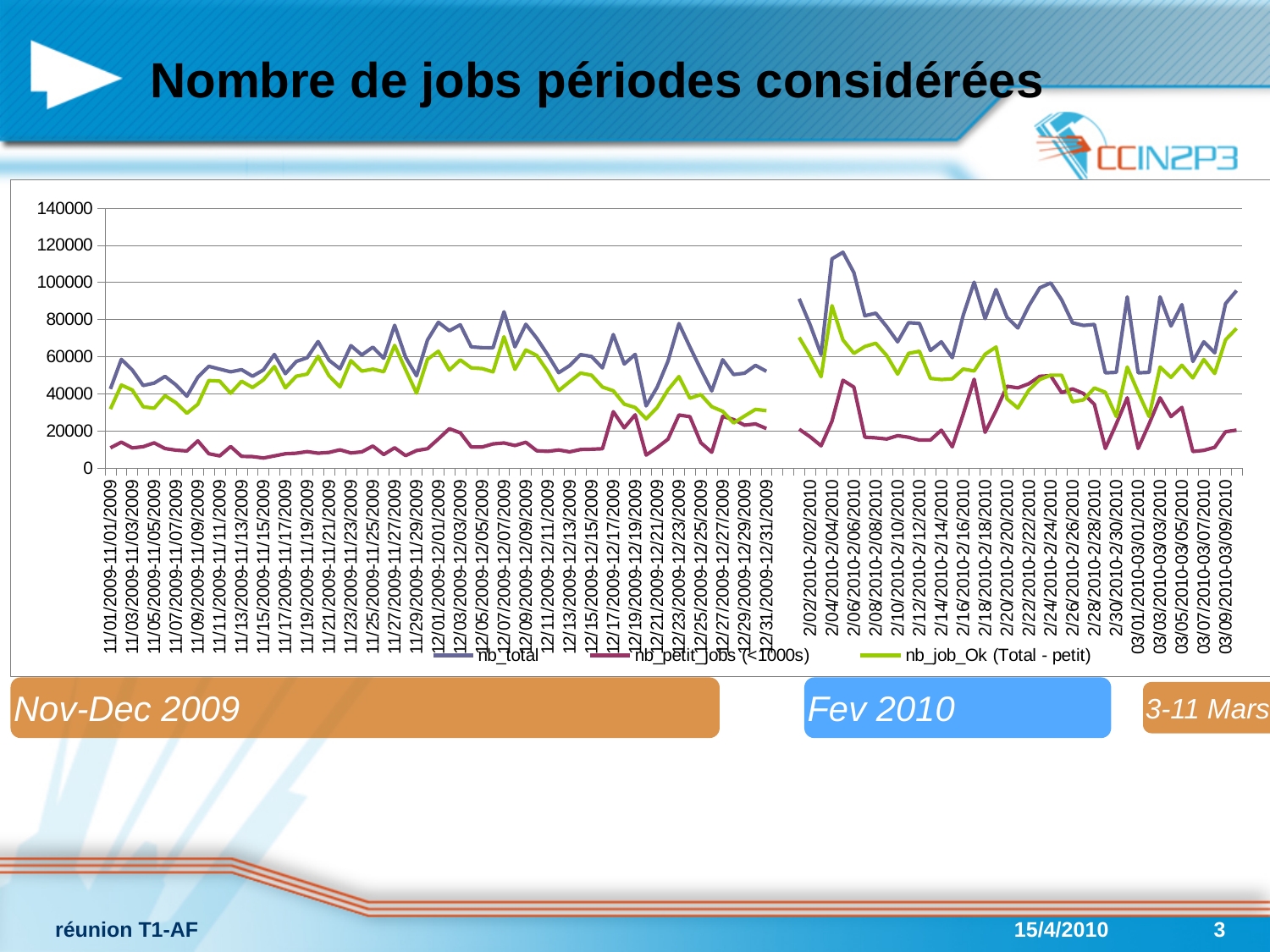
At 2/04/2010, which is larger: nb_total or nb_petit_jobs (<1000s)? nb_total Which series reaches the highest value anywhere on the chart? nb_total What is the title of the slide containing the chart? Nombre de jobs périodes considérées What kind of chart is shown on the slide? line chart Between 2/04/2010 and 2/08/2010, does nb_total rise or fall? fall Which series is plotted with the green line? nb_job_Ok (Total - petit) How many series does the chart legend list? 3 Is the peak value of nb_total around 2/04/2010 greater or less than 100000? greater Is the value of nb_petit_jobs (<1000s) at 11/01/2009 greater or less than 20000? less What is the highest value shown on the vertical axis? 140000 Is the value of nb_job_Ok (Total - petit) at 2/04/2010 greater or less than 60000? greater